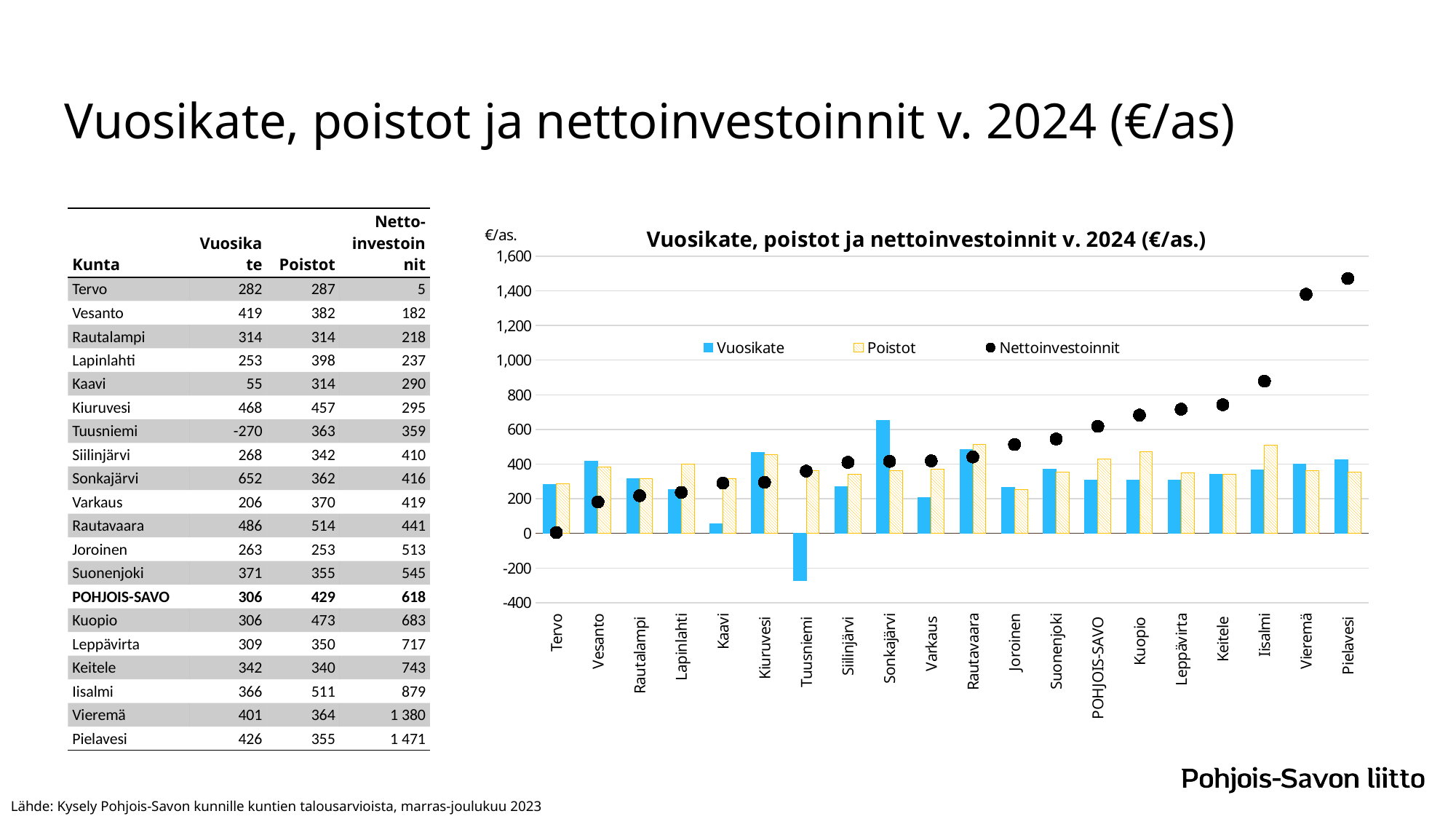
How many municipalities (categories) are plotted along the x axis of the chart? 20 What are the three entries in the chart legend? Vuosikate, Poistot, Nettoinvestoinnit What is the Nettoinvestoinnit value for Vieremä? 1 380 What is the Vuosikate value for Sonkajärvi? 652 How many series does the chart legend list? 3 What kind of chart is shown on the slide? bar chart (with dot markers for Nettoinvestoinnit) Which municipality has the highest Nettoinvestoinnit value? Pielavesi What is the difference between Poistot and Vuosikate for Kaavi? 259 Is the Vuosikate bar for Sonkajärvi greater or less than 600? greater Do the Nettoinvestoinnit values rise or fall from left to right along the x axis? rise For Lapinlahti, which is larger: Vuosikate or Poistot? Poistot Which municipality has the lowest Vuosikate value? Tuusniemi